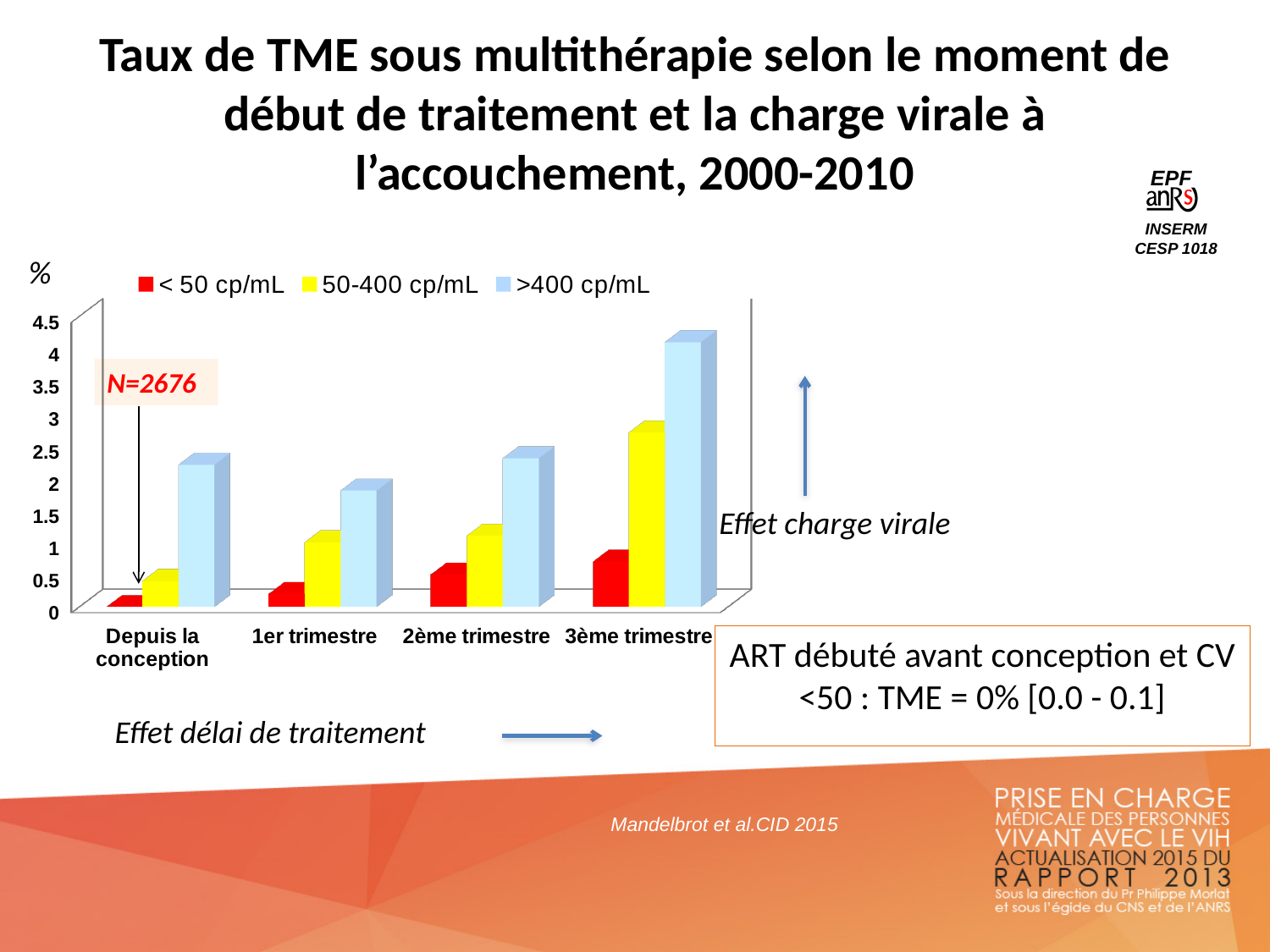
Which category has the lowest value for the < 50 cp/mL series? Depuis la conception Is the value for >400 cp/mL at 1er trimestre greater or less than 2.5? less Which category has the highest value for the >400 cp/mL series? 3ème trimestre Which is larger for the 50-400 cp/mL series: 2ème trimestre or 3ème trimestre? 3ème trimestre What kind of chart is shown on the slide? bar chart Is the value for 50-400 cp/mL at 3ème trimestre greater or less than 2? greater How many treatment-start categories are shown on the x axis? 4 Which legend entry is shown in red? < 50 cp/mL Is the value for >400 cp/mL at 3ème trimestre greater or less than 3.5? greater How many series does the legend list? 3 Do the values for the < 50 cp/mL series rise or fall from Depuis la conception to 3ème trimestre? rise